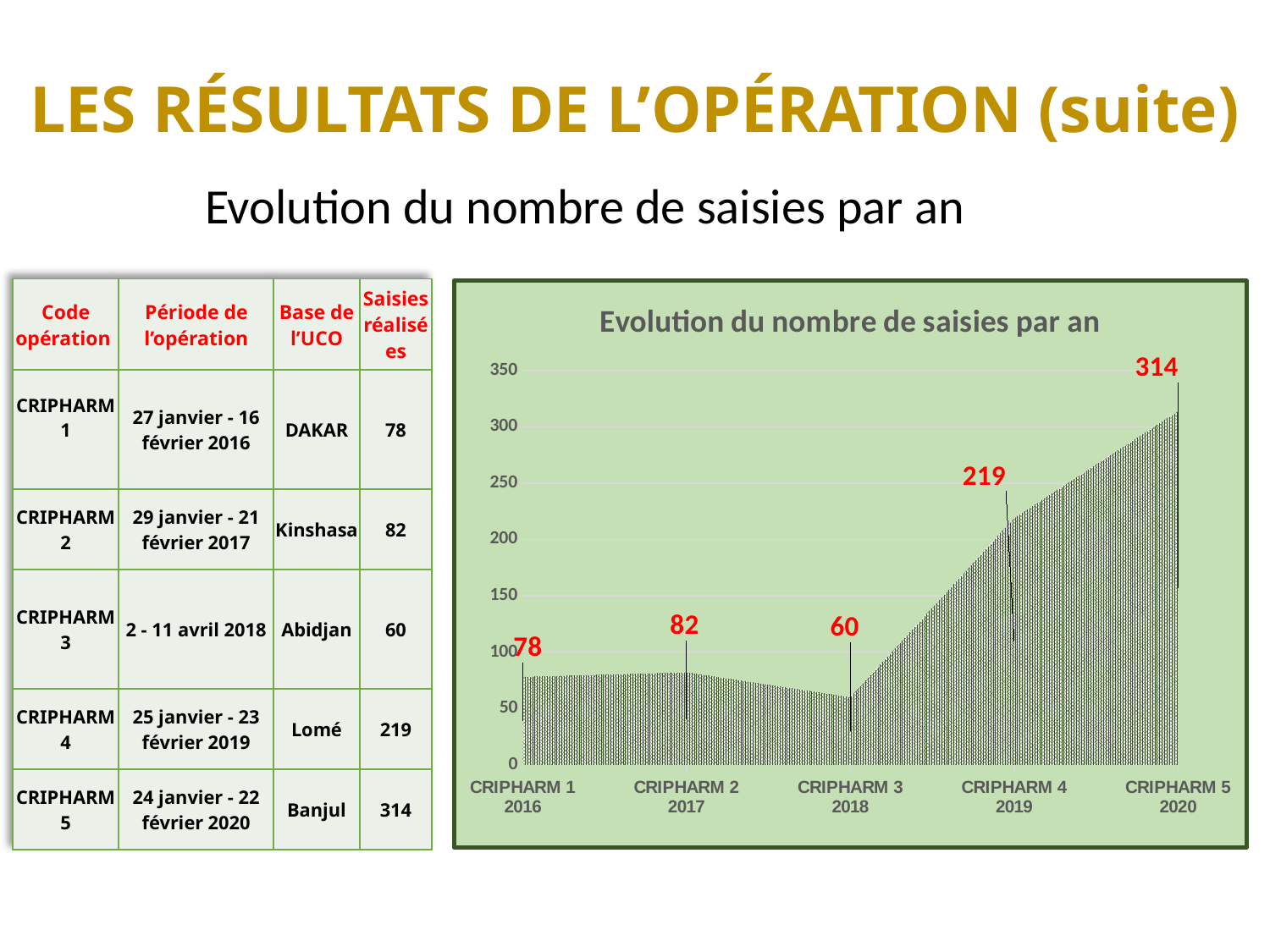
What is the value for CRIPHARM 3 (2018) in the chart? 60 Which operation has the lowest number of seizures in the chart? CRIPHARM 3 (2018) Which operation has the highest number of seizures in the chart? CRIPHARM 5 (2020) What is the value for CRIPHARM 5 (2020) in the chart? 314 What is the title of the chart? Evolution du nombre de saisies par an What is the difference between the values for CRIPHARM 5 and CRIPHARM 4? 95 What is the value for CRIPHARM 2 (2017) in the chart? 82 What is the difference between the values for CRIPHARM 2 and CRIPHARM 1? 4 Which is larger, the value for CRIPHARM 4 or the value for CRIPHARM 3? CRIPHARM 4 What type of chart is shown on the slide? Area chart How many operations (categories) are plotted on the x axis of the chart? 5 Is the value for CRIPHARM 4 greater or less than 200? greater